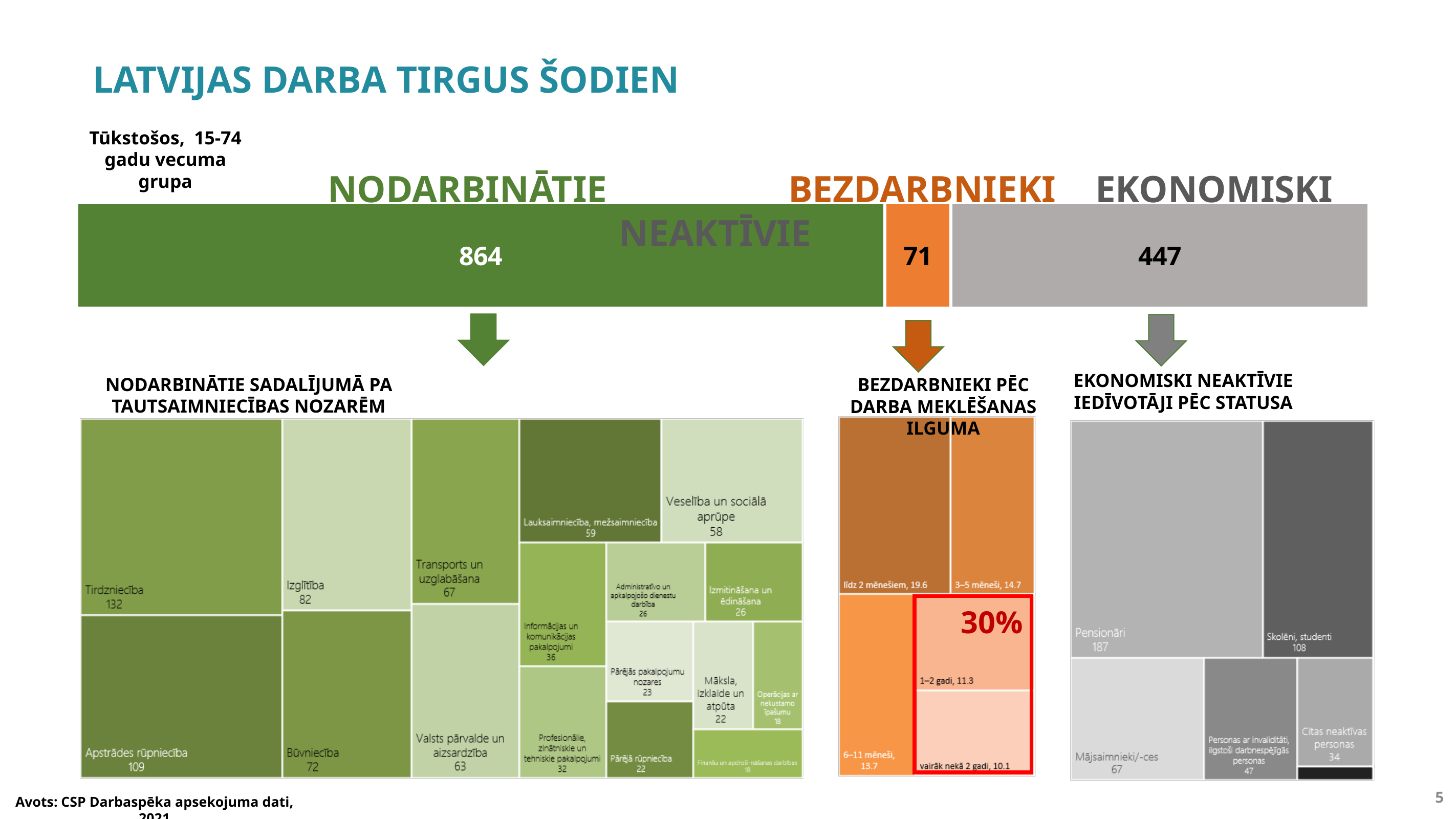
In the chart 'BEZDARBNIEKI PĒC DARBA MEKLĒŠANAS ILGUMA', which category has the lowest value? vairāk nekā 2 gadi In the top stacked bar, what is the value for BEZDARBNIEKI? 71 How many categories are shown in the chart 'BEZDARBNIEKI PĒC DARBA MEKLĒŠANAS ILGUMA'? 5 In the chart 'NODARBINĀTIE SADALĪJUMĀ PA TAUTSAIMNIECĪBAS NOZARĒM', which is larger: Izglītība or Transports un uzglabāšana? Izglītība In the chart 'BEZDARBNIEKI PĒC DARBA MEKLĒŠANAS ILGUMA', what is the value for 'līdz 2 mēnešiem'? 19.6 In the chart 'NODARBINĀTIE SADALĪJUMĀ PA TAUTSAIMNIECĪBAS NOZARĒM', what is the difference between Tirdzniecība (132) and Apstrādes rūpniecība (109)? 23 In the top stacked bar, what is the difference between NODARBINĀTIE (864) and EKONOMISKI NEAKTĪVIE (447)? 417 In the chart 'NODARBINĀTIE SADALĪJUMĀ PA TAUTSAIMNIECĪBAS NOZARĒM', which sector has the highest value? Tirdzniecība In the top stacked bar, what is the total of the three segments (864, 71 and 447)? 1382 In the top stacked bar, what is the value for NODARBINĀTIE? 864 In the chart 'EKONOMISKI NEAKTĪVIE IEDZĪVOTĀJI PĒC STATUSA', what is the value for Pensionāri? 187 In the chart 'NODARBINĀTIE SADALĪJUMĀ PA TAUTSAIMNIECĪBAS NOZARĒM', what is the value for Būvniecība? 72